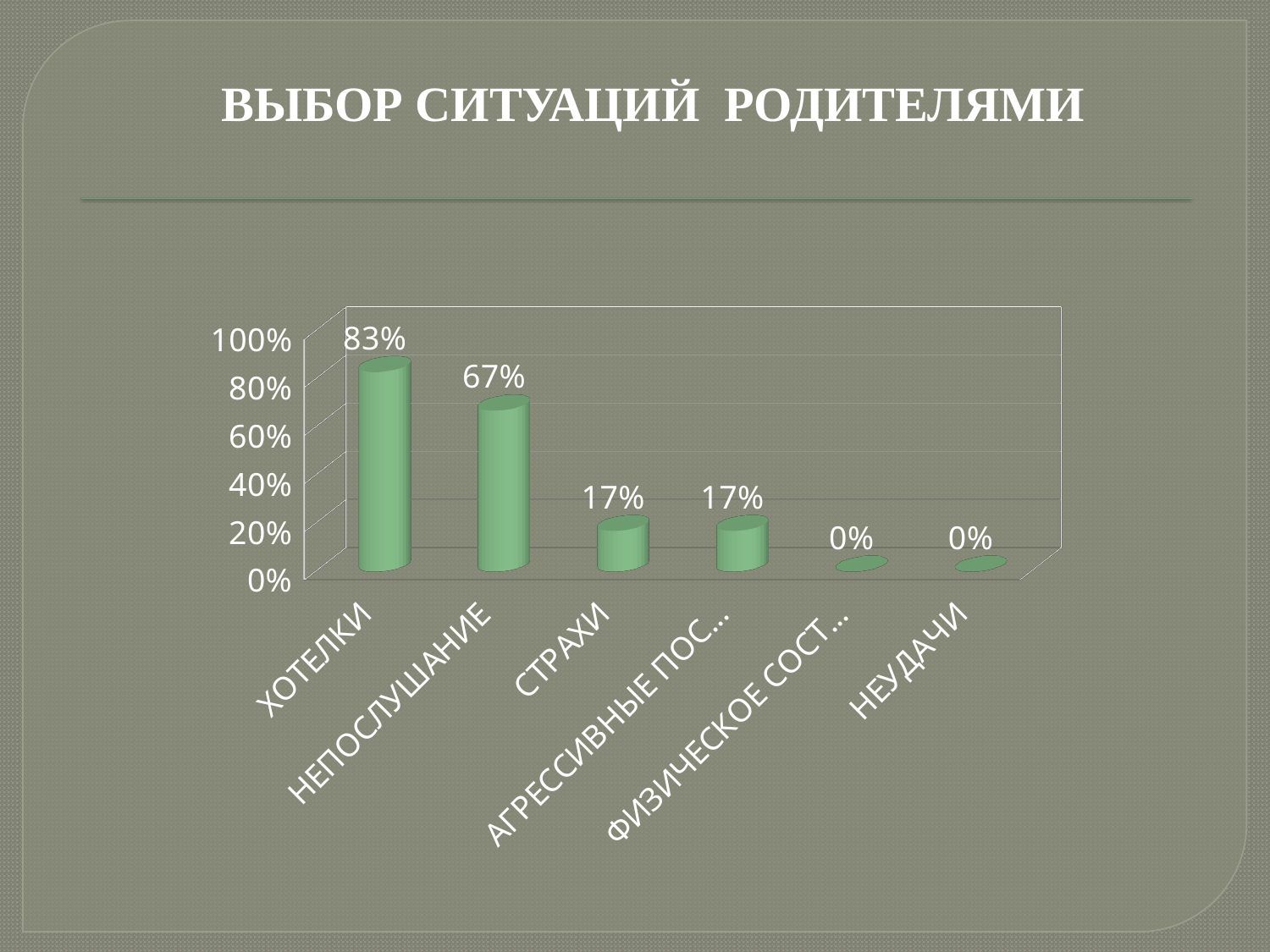
How many categories are shown on the x axis? 6 What kind of chart is shown on the slide? bar chart Which category has the highest value? ХОТЕЛКИ What is the value for НЕПОСЛУШАНИЕ? 67% What is the difference between the values for ХОТЕЛКИ and НЕПОСЛУШАНИЕ? 16% Which is larger, the value for НЕПОСЛУШАНИЕ or the value for СТРАХИ? НЕПОСЛУШАНИЕ What is the value for НЕУДАЧИ? 0% What is the value for СТРАХИ? 17% What is the difference between the values for НЕПОСЛУШАНИЕ and СТРАХИ? 50% What is the value for ХОТЕЛКИ? 83% What is the title of the chart on the slide? ВЫБОР СИТУАЦИЙ РОДИТЕЛЯМИ What is the value of the fourth bar from the left? 17%